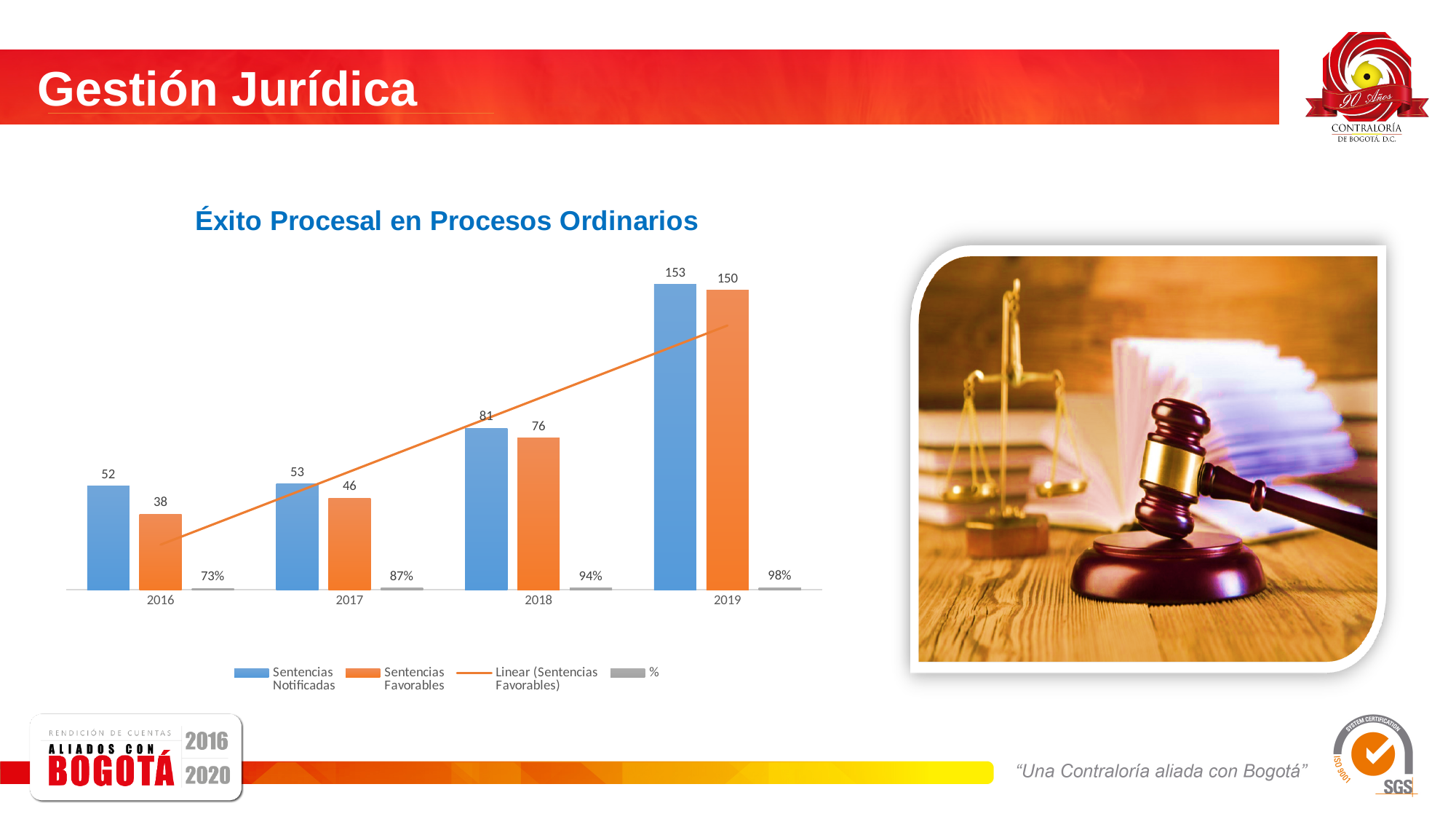
Which year has the highest value of Sentencias Favorables? 2019 Which year has the lowest value of Sentencias Notificadas? 2016 Which is larger in 2017: Sentencias Notificadas or Sentencias Favorables? Sentencias Notificadas How many entries does the legend list? 4 What is the title of the chart? Éxito Procesal en Procesos Ordinarios What is the difference between Sentencias Notificadas and Sentencias Favorables in 2018? 5 Do the Sentencias Favorables values rise or fall from 2016 to 2019? Rise What is the value of Sentencias Notificadas for 2019? 153 What percentage (%) is shown for 2017? 87% What is the value of Sentencias Favorables for 2016? 38 What kind of chart is this? Bar chart with a trend line How many years are shown on the x axis? 4